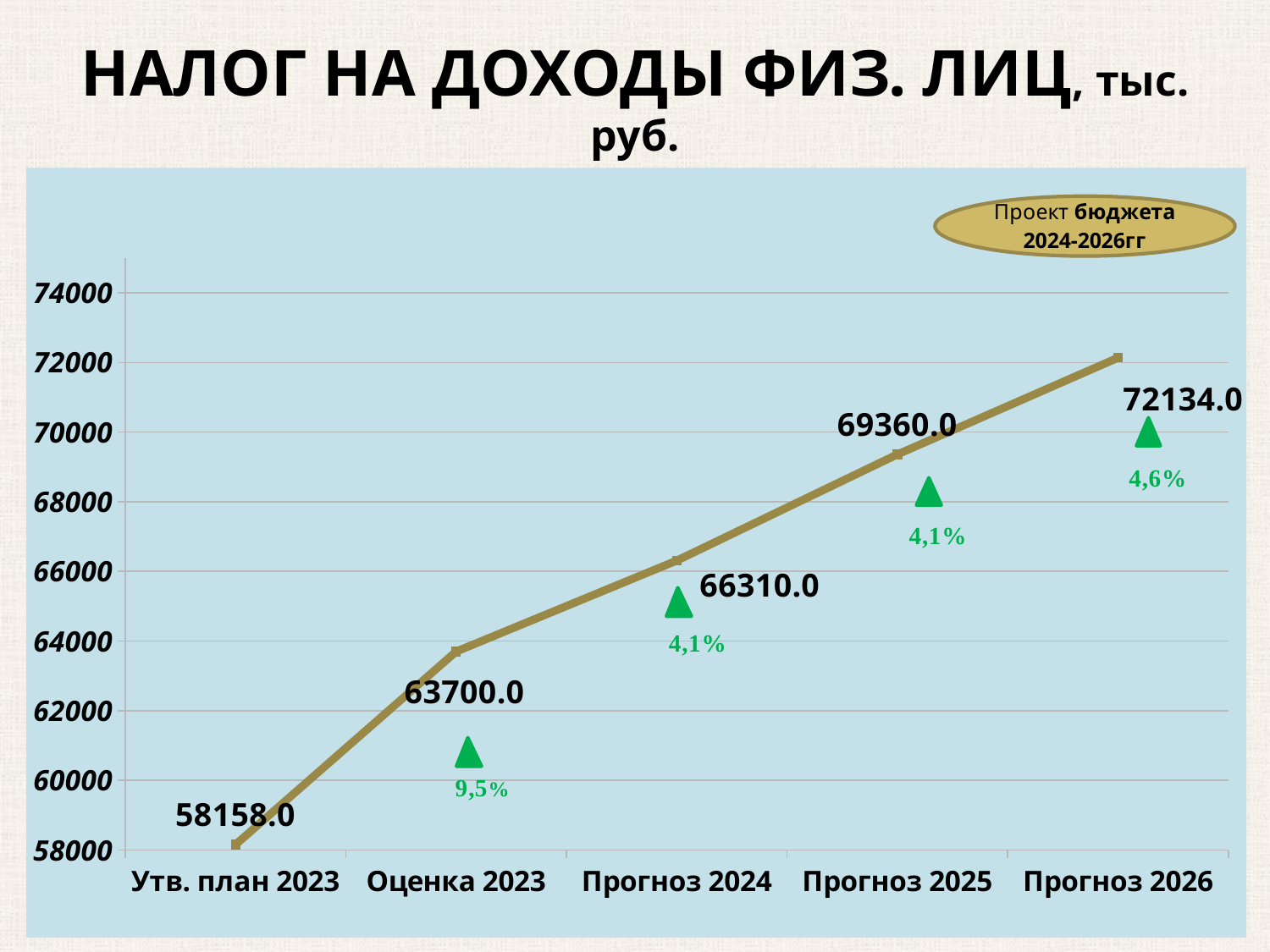
What is the value for Прогноз 2024? 66310.0 Which is larger, the value for Прогноз 2024 or the value for Оценка 2023? Прогноз 2024 What is the value for Прогноз 2026? 72134.0 What is the difference between the values for Оценка 2023 and Утв. план 2023? 5542.0 What is the value for Утв. план 2023? 58158.0 Which category has the highest value? Прогноз 2026 Which category has the lowest value? Утв. план 2023 What is the difference between the values for Прогноз 2026 and Прогноз 2025? 2774.0 How many categories are shown on the x axis? 5 What is the value for Прогноз 2025? 69360.0 What is the value for Оценка 2023? 63700.0 What kind of chart is shown on the slide? line chart